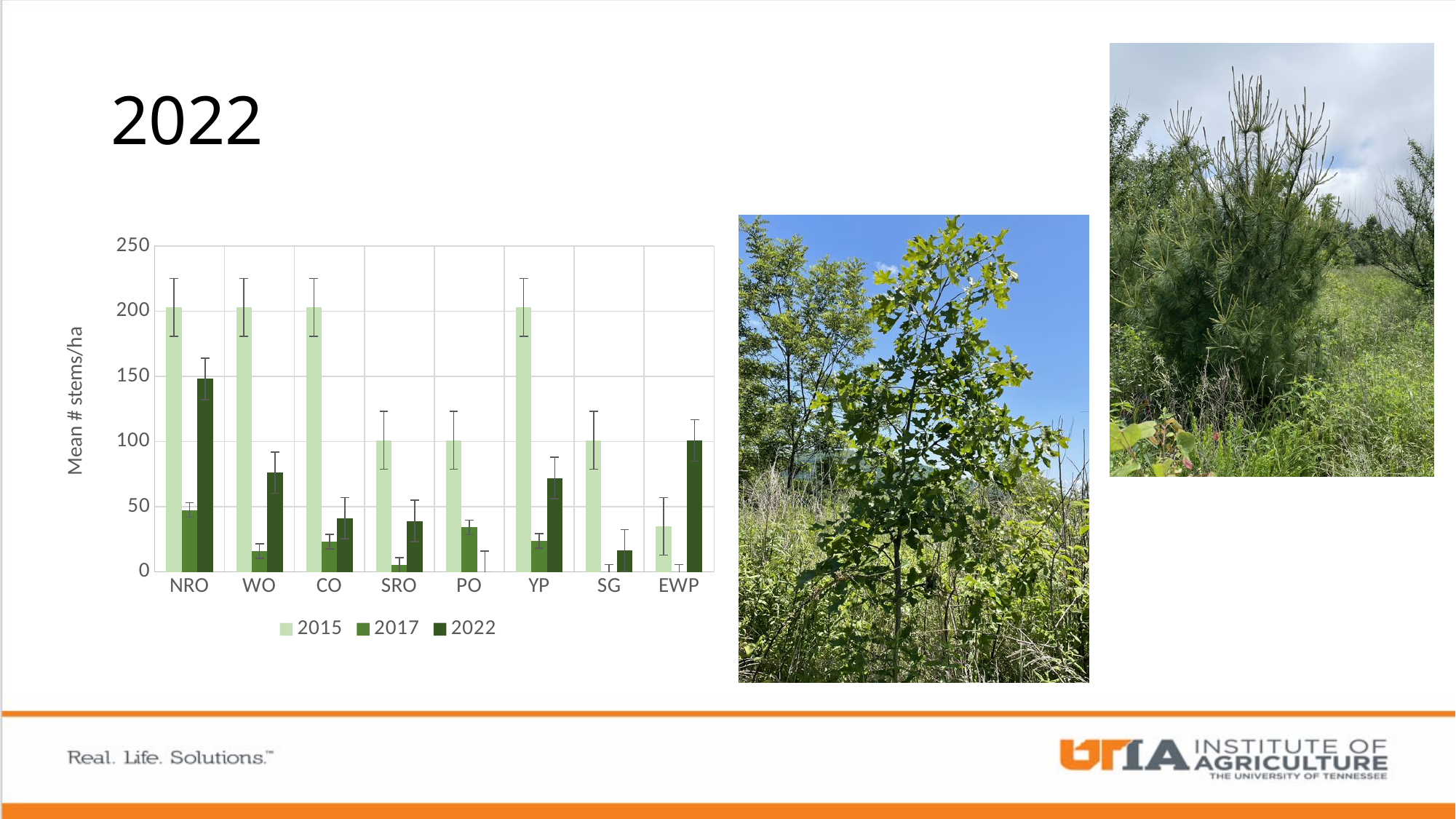
Which category has the lowest 2015 value? EWP How many series does the chart legend list? 3 For NRO, do the values rise or fall from 2015 to 2022? fall What kind of chart is shown on the slide? bar chart Which category has the lowest 2022 value? PO Is the 2022 value for CO greater or less than 50? less Which is larger for WO: the 2017 value or the 2022 value? 2022 How many species categories are shown on the x axis of the chart? 8 Is the 2015 value for NRO greater or less than 150? greater Which category has the highest 2022 value? NRO Which years are listed in the chart legend? 2015, 2017, 2022 What is the label on the y axis of the chart? Mean # stems/ha